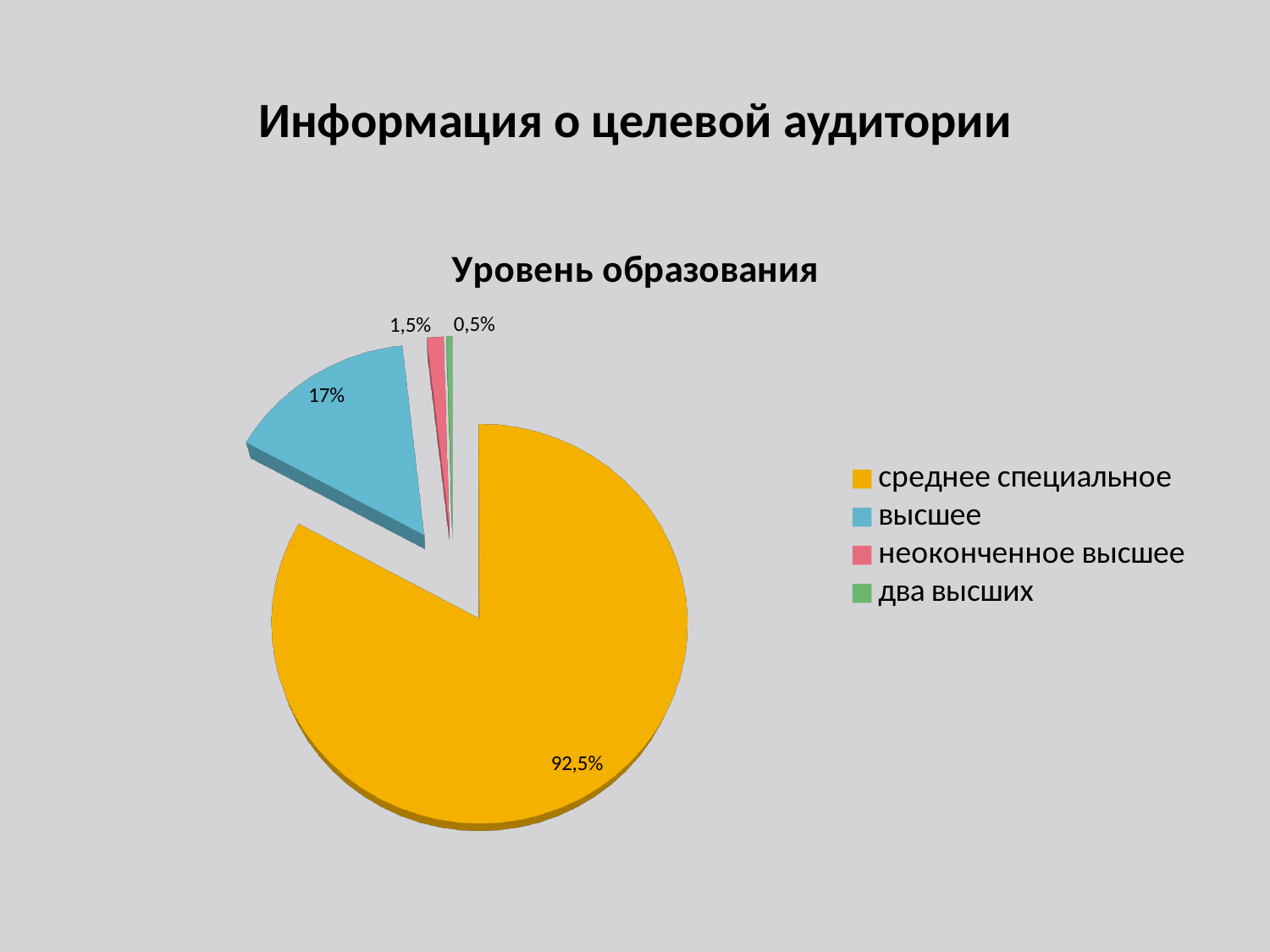
Which is larger, the slice for "высшее" or the slice for "неоконченное высшее"? высшее What percentage is shown for the "неоконченное высшее" slice? 1,5% Which category has the smallest slice of the pie? два высших What kind of chart is shown on the slide? pie chart What percentage is shown for the "два высших" slice? 0,5% What colour is the "высшее" slice? blue Which category has the largest slice of the pie? среднее специальное What percentage is shown for the "среднее специальное" slice? 92,5% How many categories does the legend list? 4 What percentage is shown for the "высшее" slice? 17% What is the difference between the "среднее специальное" and "высшее" percentages? 75,5% What is the title of the chart? Уровень образования